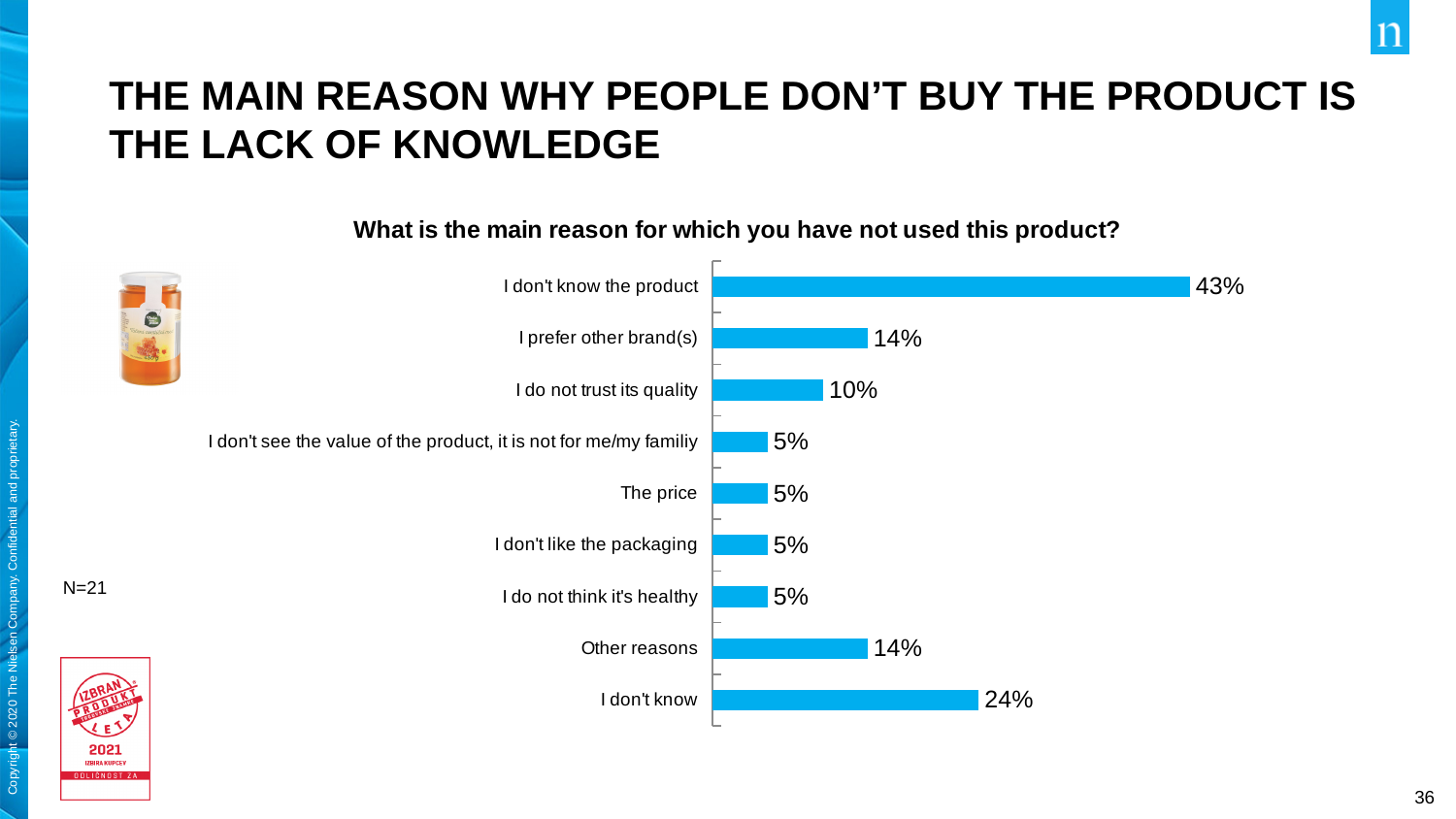
Which reason has the highest value? I don't know the product What kind of chart is shown on the slide? Bar chart What is the value for "I do not trust its quality"? 10% What is the value for "The price"? 5% Which is larger, "I do not trust its quality" or "Other reasons"? Other reasons What is the difference between "I don't know the product" and "I don't know"? 19% What percentage of respondents said "I don't know the product"? 43% What is the difference between "I prefer other brand(s)" and "I do not trust its quality"? 4% How many reason categories are shown in the chart? 9 What question is the chart based on, as shown in its title? What is the main reason for which you have not used this product? What is the value for "I prefer other brand(s)"? 14% What is the value for "I don't know"? 24%